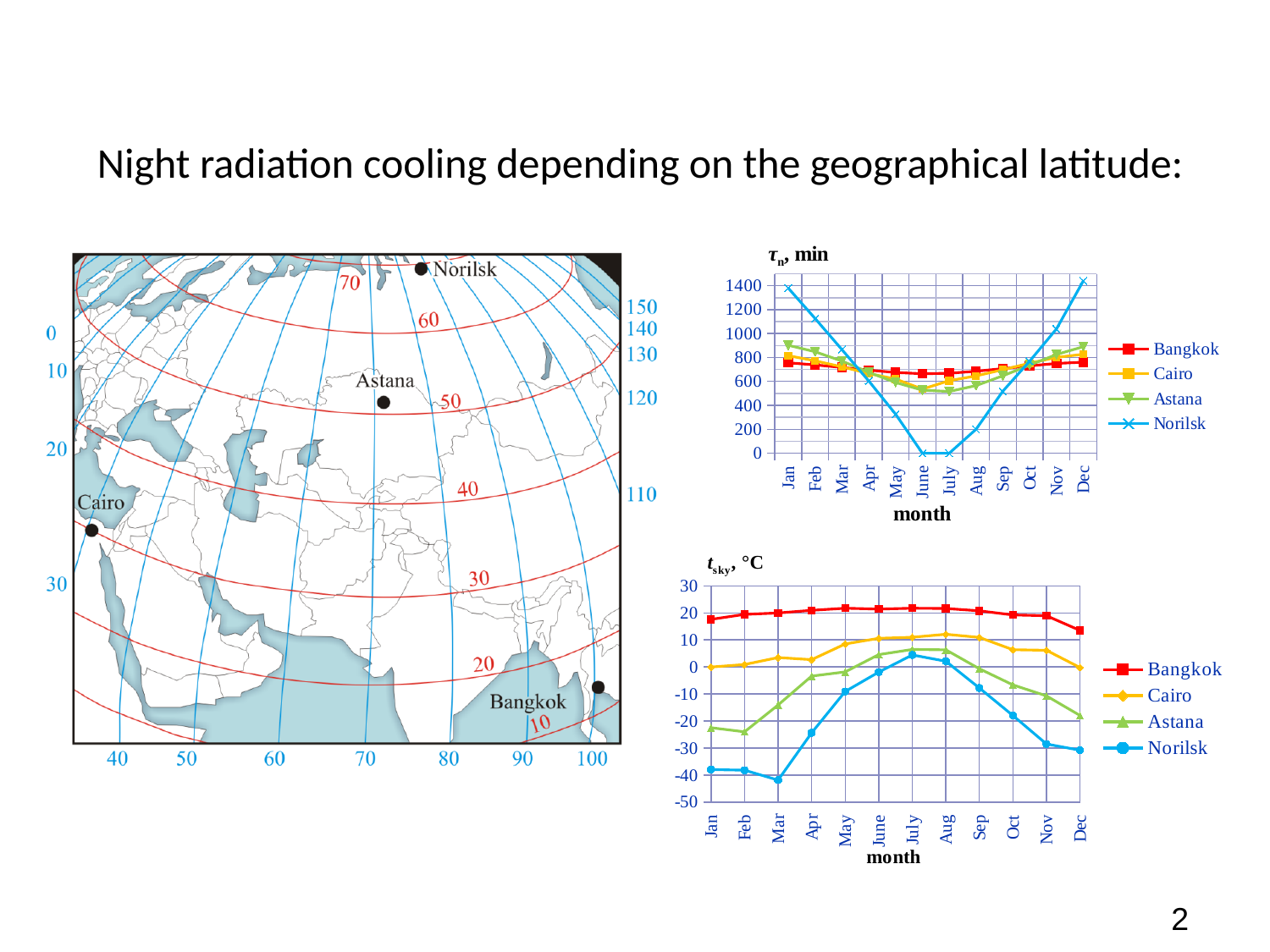
In the top-right chart (τn, min), is the value for Norilsk in January greater or less than 1200? greater In the bottom-right chart (tsky, °C), which series has the lowest value in March? Norilsk In the top-right chart (τn, min), which is larger in December: Norilsk or Bangkok? Norilsk In the bottom-right chart (tsky, °C), does the Norilsk series rise or fall from January to July? rises In the bottom-right chart (tsky, °C), is the value for Norilsk in March greater or less than -40? less What kind of chart is the top-right chart (τn, min)? line chart How many series does the legend of the top-right chart (τn, min) list? 4 How many months are plotted along the x axis of the top-right chart (τn, min)? 12 In the bottom-right chart (tsky, °C), is the value for Bangkok in May greater or less than 20? greater What kind of chart is the bottom-right chart (tsky, °C)? line chart In the top-right chart (τn, min), which series has the highest value in January? Norilsk